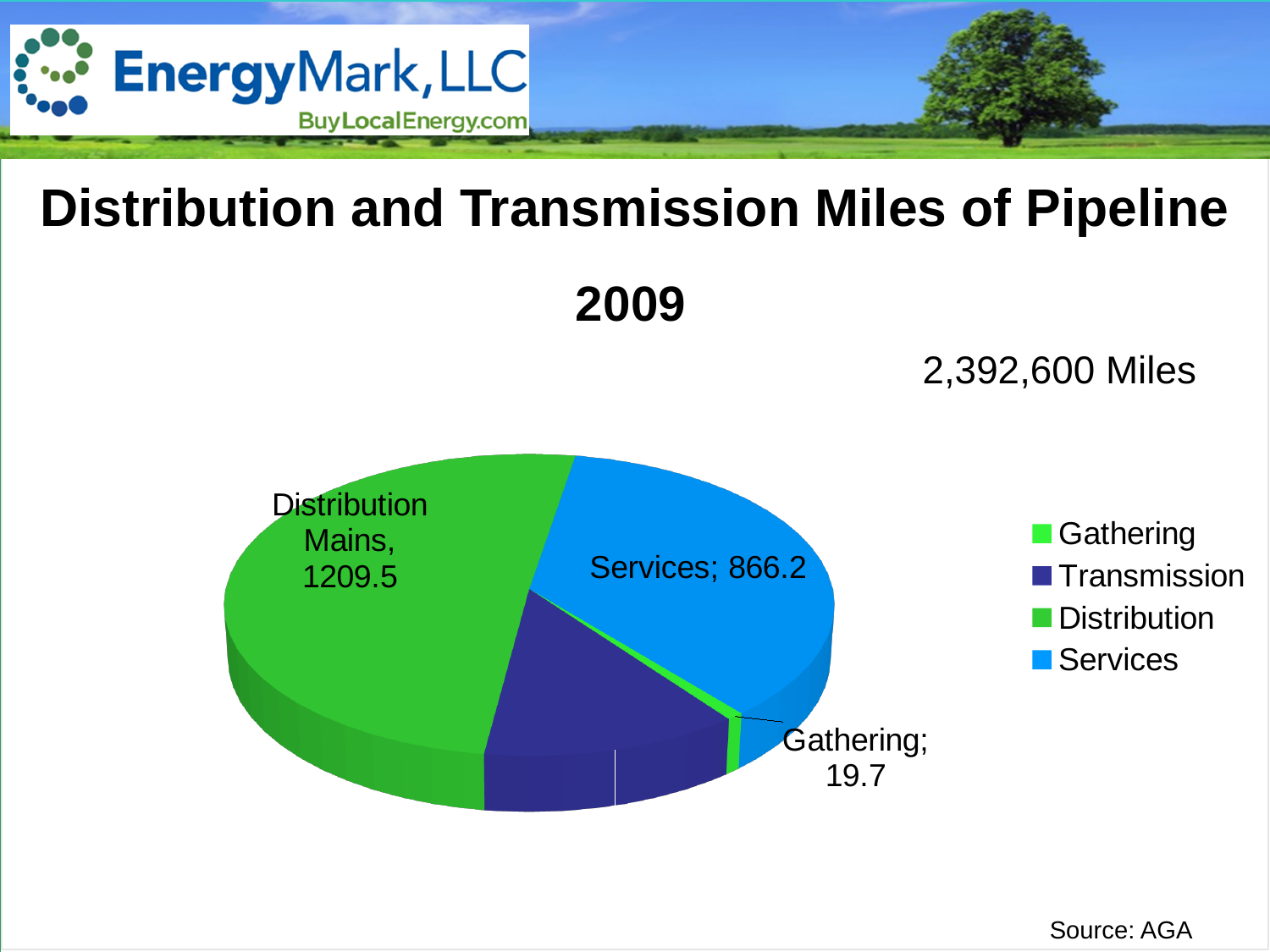
Which slice of the pie chart is the largest? Distribution Mains What total mileage is stated above the pie chart? 2,392,600 Miles Which slice of the pie chart is the smallest? Gathering What value is shown for the Gathering slice? 19.7 What is the difference between the Distribution Mains value and the Services value? 343.3 How many slices does the pie chart have? 4 What value is shown for the Services slice of the pie chart? 866.2 What kind of chart is shown on the slide? Pie chart What value is shown for the Distribution Mains slice? 1209.5 How many entries does the legend list? 4 Which slice is larger, Services or Transmission? Services What is the difference between the Services value and the Gathering value? 846.5